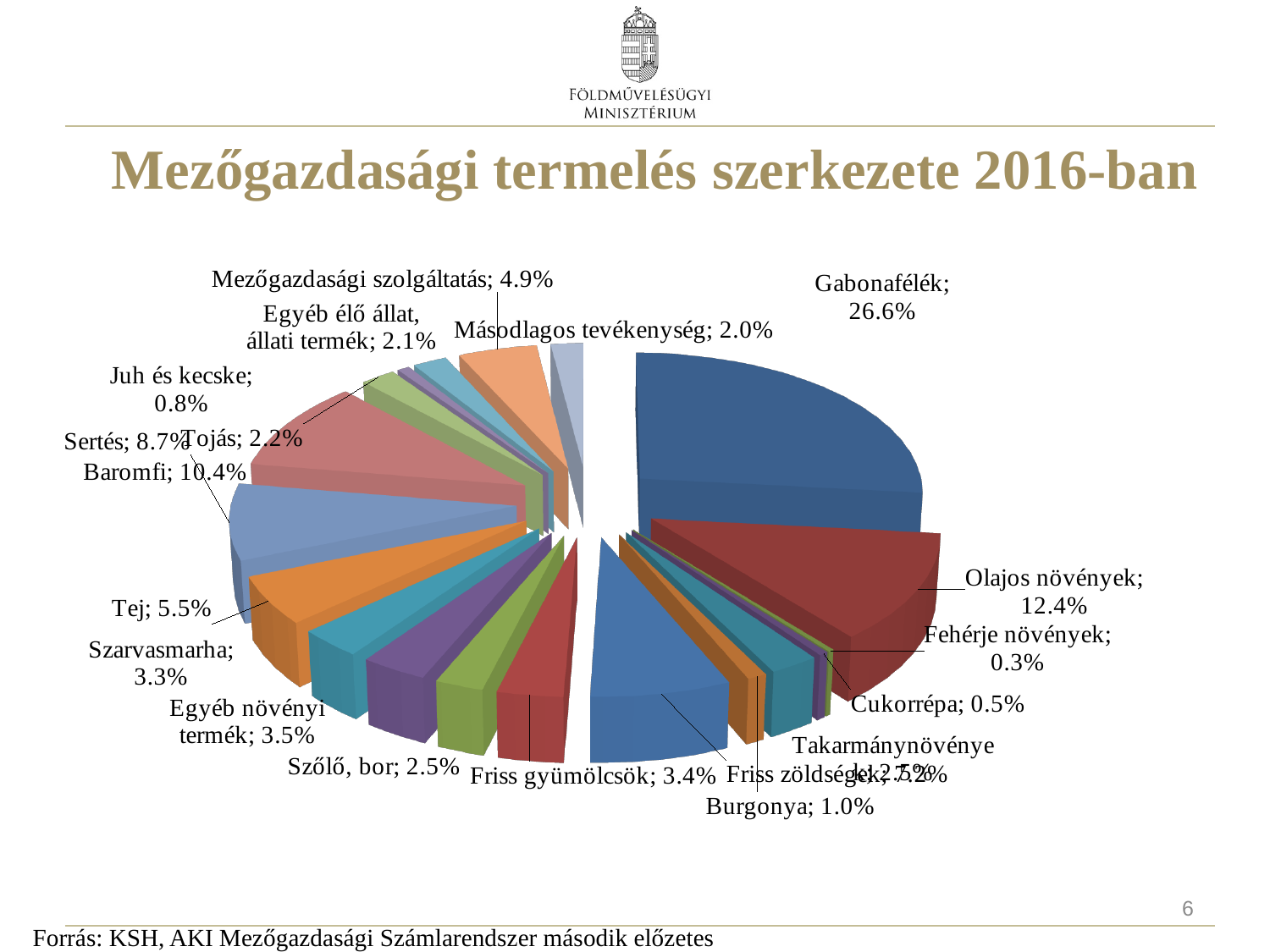
Which is larger, the share of Tej or the share of Szarvasmarha? Tej What share does Gabonafélék have in the pie chart? 26.6% What is the value shown for Olajos növények? 12.4% Which category has the largest share of the pie? Gabonafélék What is the value shown for Baromfi? 10.4% What is the difference between the shares of Gabonafélék and Olajos növények? 14.2% What is the difference between the shares of Baromfi and Sertés? 1.7% What kind of chart is shown on the slide? pie chart What is the value shown for Mezőgazdasági szolgáltatás? 4.9% What is the title of the chart on the slide? Mezőgazdasági termelés szerkezete 2016-ban Which category has the smallest share of the pie? Fehérje növények What is the value shown for Sertés? 8.7%